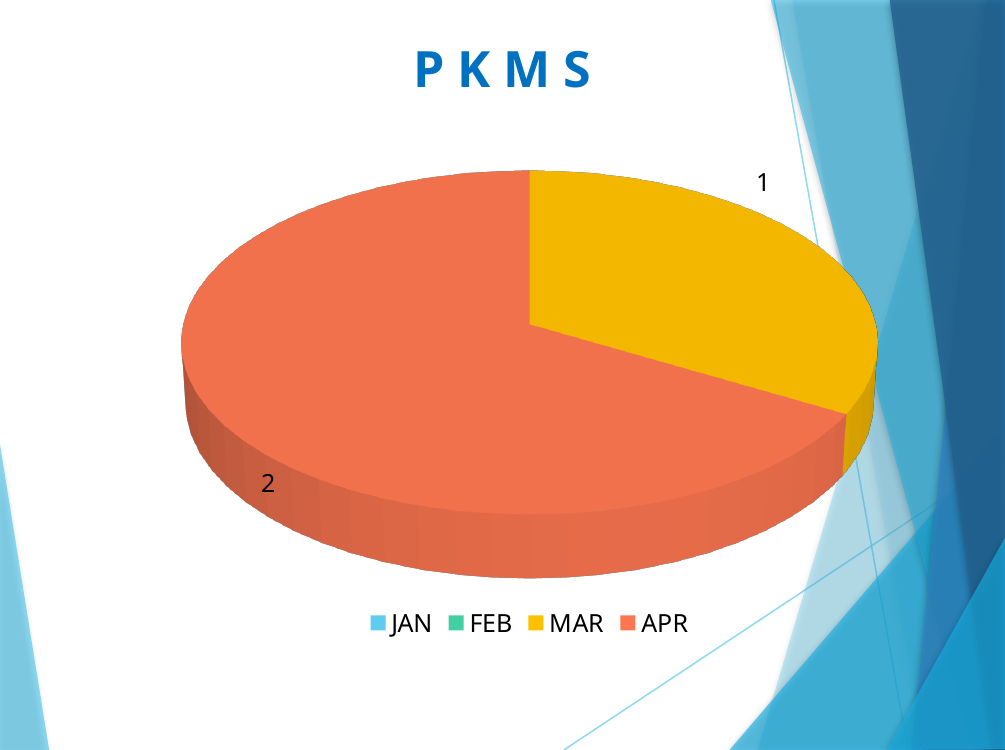
Of the two visible slices, MAR and APR, which is smaller? MAR How many entries does the chart's legend list? 4 What colour is the APR slice? orange What is the value labelled on the APR slice? 2 Which category has the largest slice of the pie? APR What is the value labelled on the MAR slice? 1 How many slices are visible in the pie? 2 What is the total of the labelled values on the pie (MAR and APR)? 3 What kind of chart is shown on the slide? pie chart Which is larger, the value for MAR or the value for APR? APR What is the difference between the APR value and the MAR value? 1 What is the title of the chart? P K M S